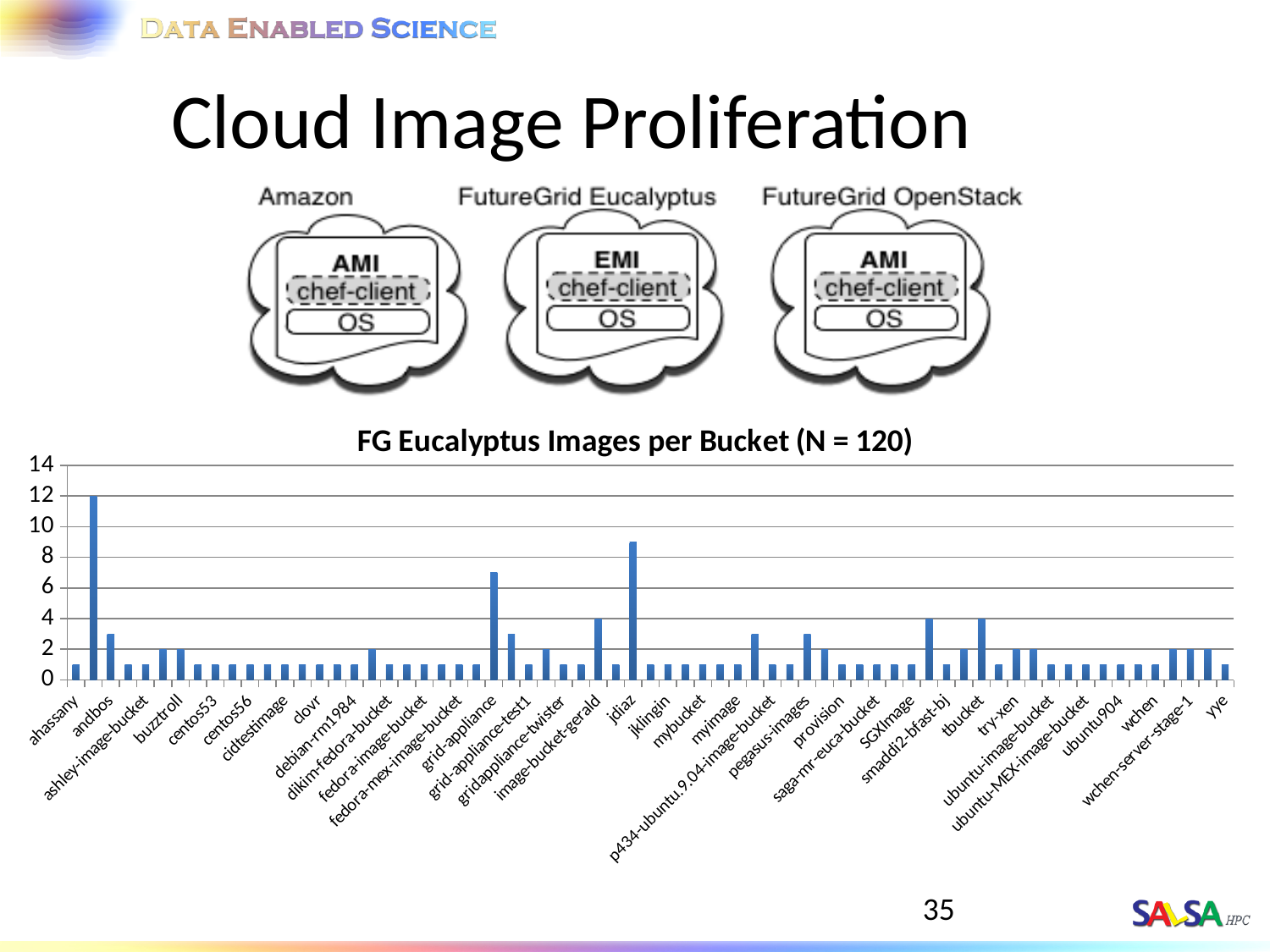
Is the value for ahassany greater or less than 2? less What is the value of the tallest bar in the chart? 12 What is the highest value shown on the vertical axis? 14 What is the title of the chart? FG Eucalyptus Images per Bucket (N = 120) What kind of chart is shown on the slide? bar chart What is the total number of images (N) stated in the chart title? 120 Is the value of the tallest bar greater or less than 10? greater Is the value for yye greater or less than 2? less How many bars reach the value 12? 1